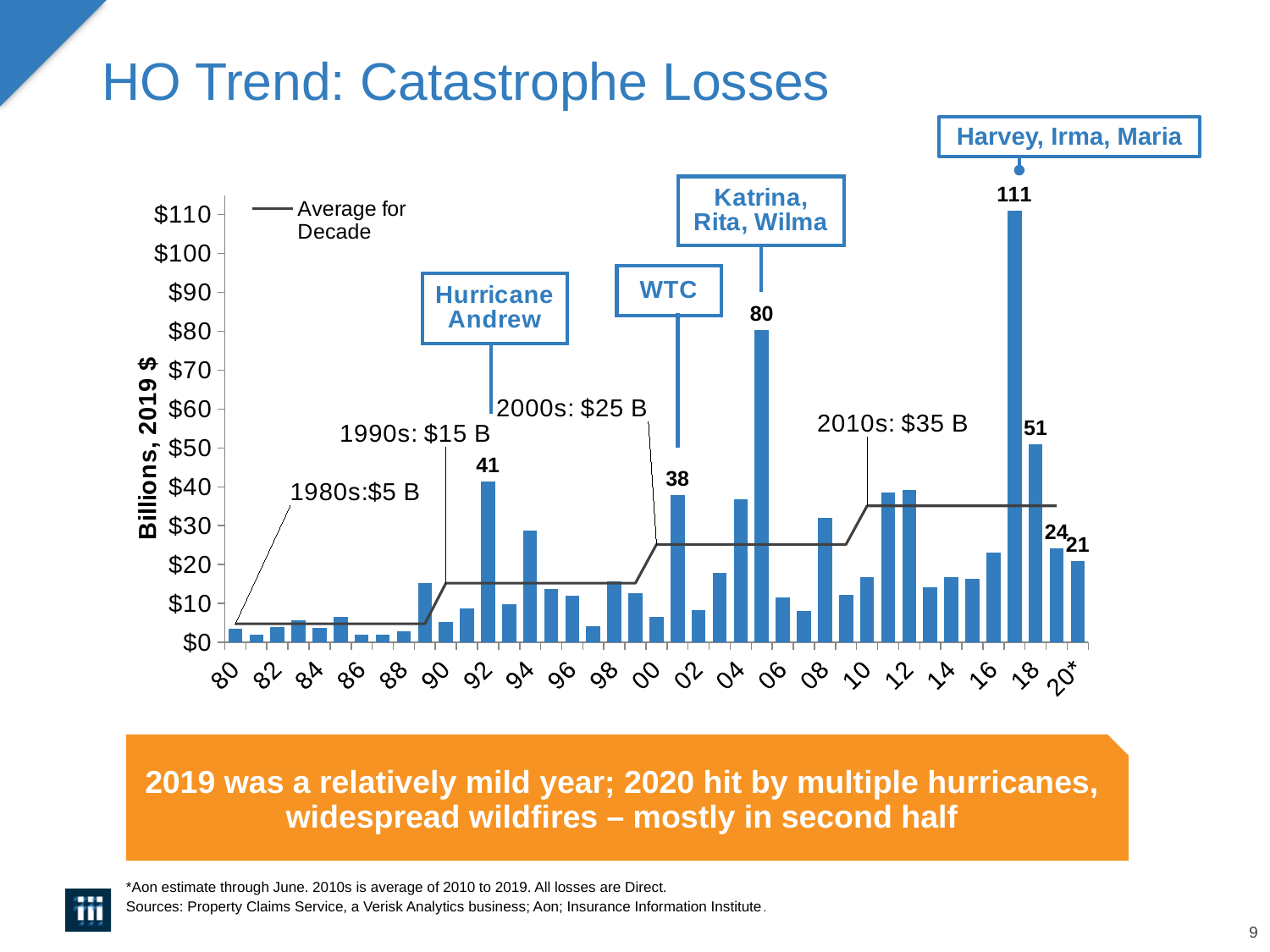
What is the catastrophe loss value labeled for 2017? 111 What is the value labeled for 2020*? 21 What is the average for the 2010s decade shown on the chart? $35 B Is the value for 2011 greater or less than $30? greater Which year has the larger labeled value, 1992 or 2001? 1992 Is the value for 1985 greater or less than $10? less What is the value labeled for 2019? 24 What is the difference between the labeled values for 2005 and 2001? 42 What is the value labeled on the bar for 2005? 80 Which year has the highest catastrophe losses in the chart? 2017 What kind of chart is shown on the slide? combination bar and line chart What is the difference between the labeled values for 2017 and 2018? 60